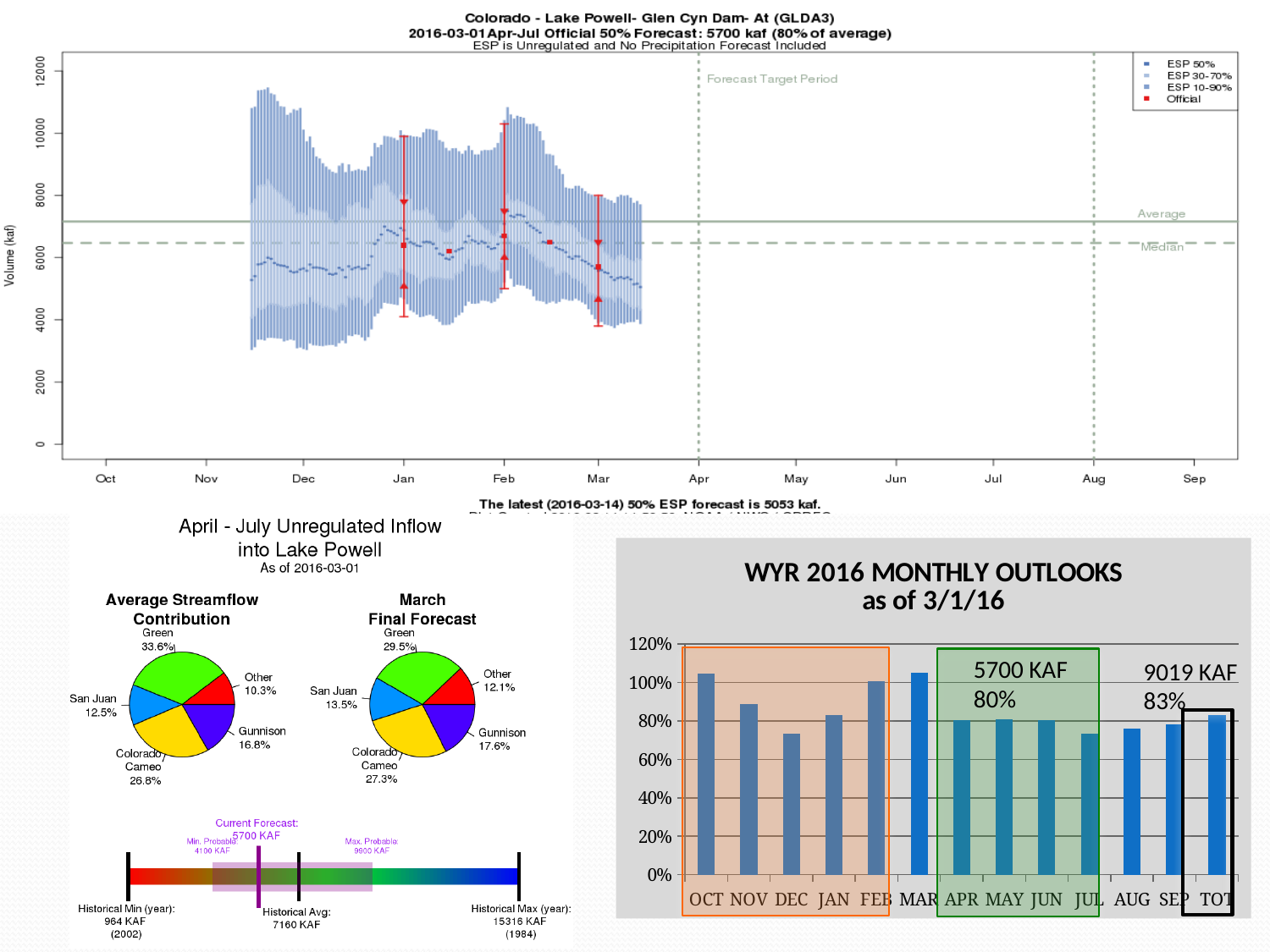
In the March Final Forecast pie chart, which basin has the smallest share? Other How many categories are shown on the x axis of the WYR 2016 MONTHLY OUTLOOKS bar chart? 13 What kind of chart is the WYR 2016 MONTHLY OUTLOOKS chart? bar chart In the Average Streamflow Contribution pie chart, what share does Green contribute? 33.6% In the Average Streamflow Contribution pie chart, which is larger, the San Juan share or the Gunnison share? Gunnison In the March Final Forecast pie chart, what share does Colorado Cameo contribute? 27.3% In the WYR 2016 MONTHLY OUTLOOKS bar chart, is the value for OCT greater or less than 100%? greater What is the difference between the Gunnison share in the March Final Forecast pie chart and the Gunnison share in the Average Streamflow Contribution pie chart? 0.8% According to the title of the top Lake Powell chart, what is the 2016-03-01 Apr-Jul Official 50% forecast? 5700 kaf In the WYR 2016 MONTHLY OUTLOOKS bar chart, is the value for DEC greater or less than 80%? less How many series does the legend of the top Lake Powell ESP forecast chart list? 4 In the Average Streamflow Contribution pie chart, which basin has the largest share? Green